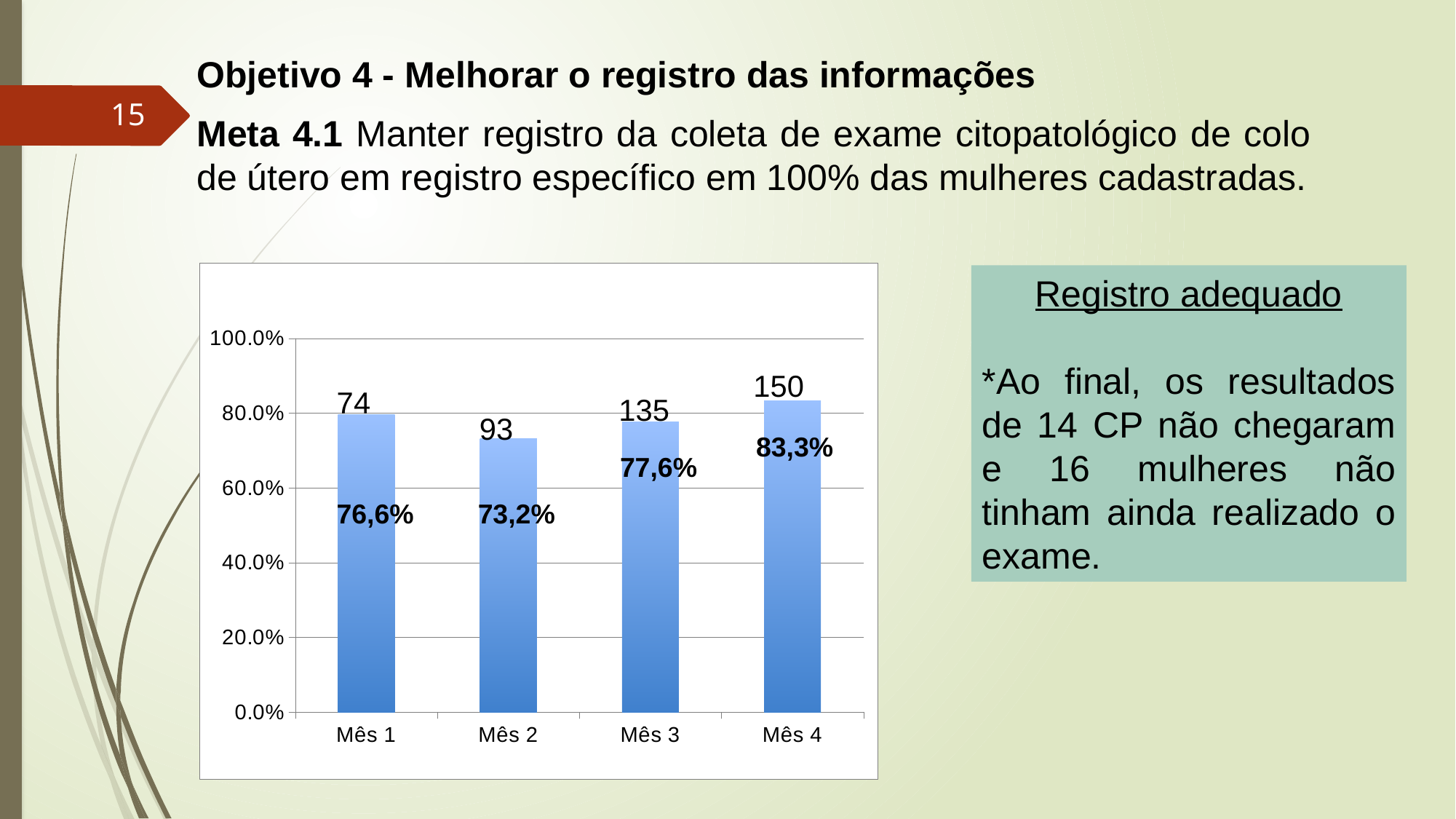
What number is printed above the bar for Mês 3? 135 What is the difference between the numbers printed above the bars for Mês 4 and Mês 1? 76 How many months are shown on the x axis? 4 What is the difference in percentage points between Mês 4 and Mês 2? 10,1 What number is printed above the bar for Mês 1? 74 Which month has the lowest percentage? Mês 2 What kind of chart is shown on the slide? bar chart What percentage is shown for Mês 2? 73,2% Which month has the highest percentage? Mês 4 Is the value for Mês 2 greater or less than 80.0%? less What percentage is shown for Mês 4? 83,3%